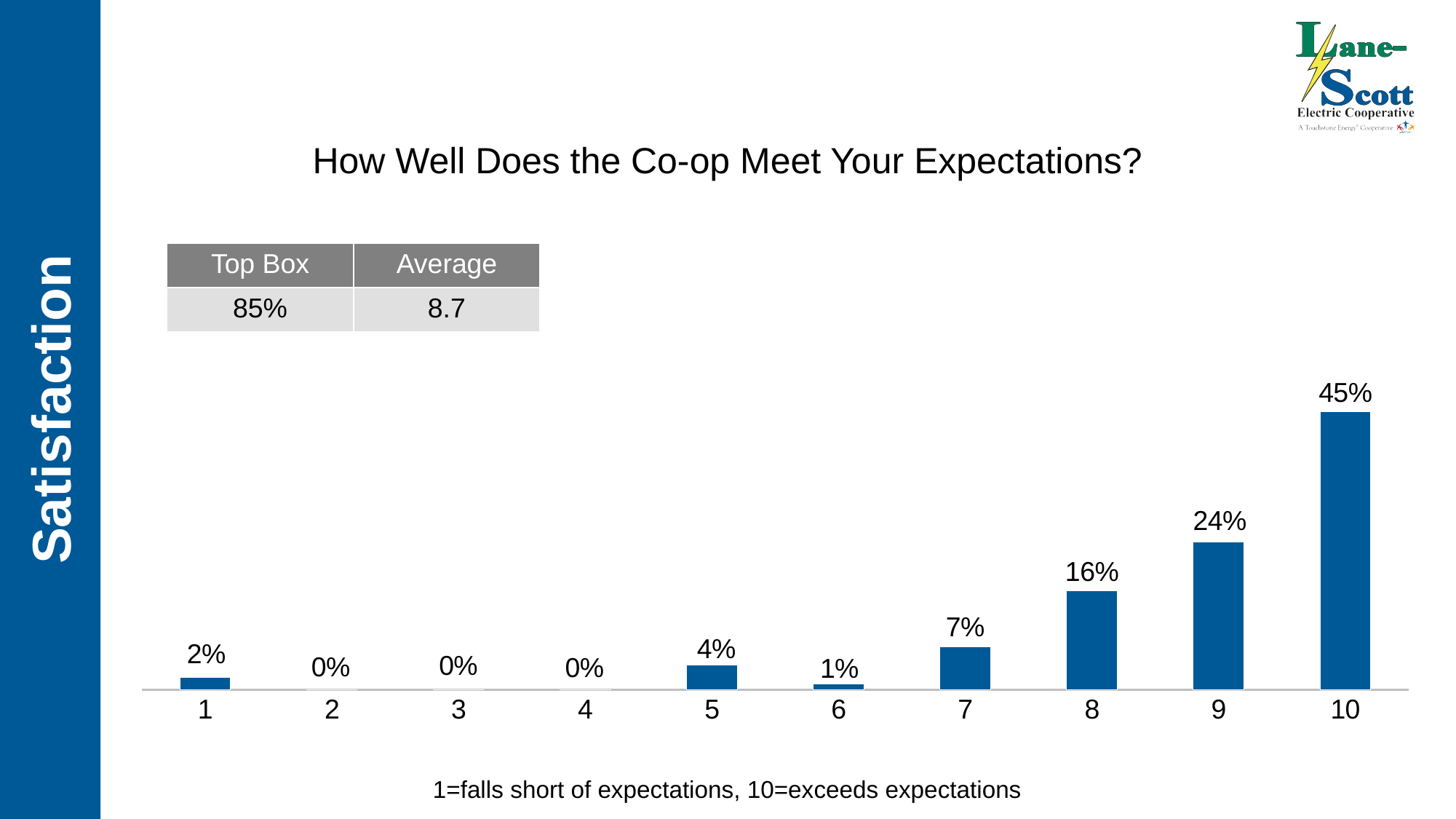
What percentage of respondents gave a rating of 10? 45% What percentage of respondents gave a rating of 8? 16% What is the difference in percentage points between ratings 8 and 7? 9 How many rating categories are shown on the x axis? 10 Do the percentages generally rise or fall from rating 5 to rating 10? rise Which has a larger percentage, rating 1 or rating 5? 5 What is the Top Box value shown in the table above the chart? 85% Which rating has the highest percentage of respondents? 10 Which has a larger percentage, rating 7 or rating 9? 9 What kind of chart is shown on the slide? bar chart What percentage of respondents gave a rating of 5? 4% What is the difference in percentage points between ratings 10 and 9? 21